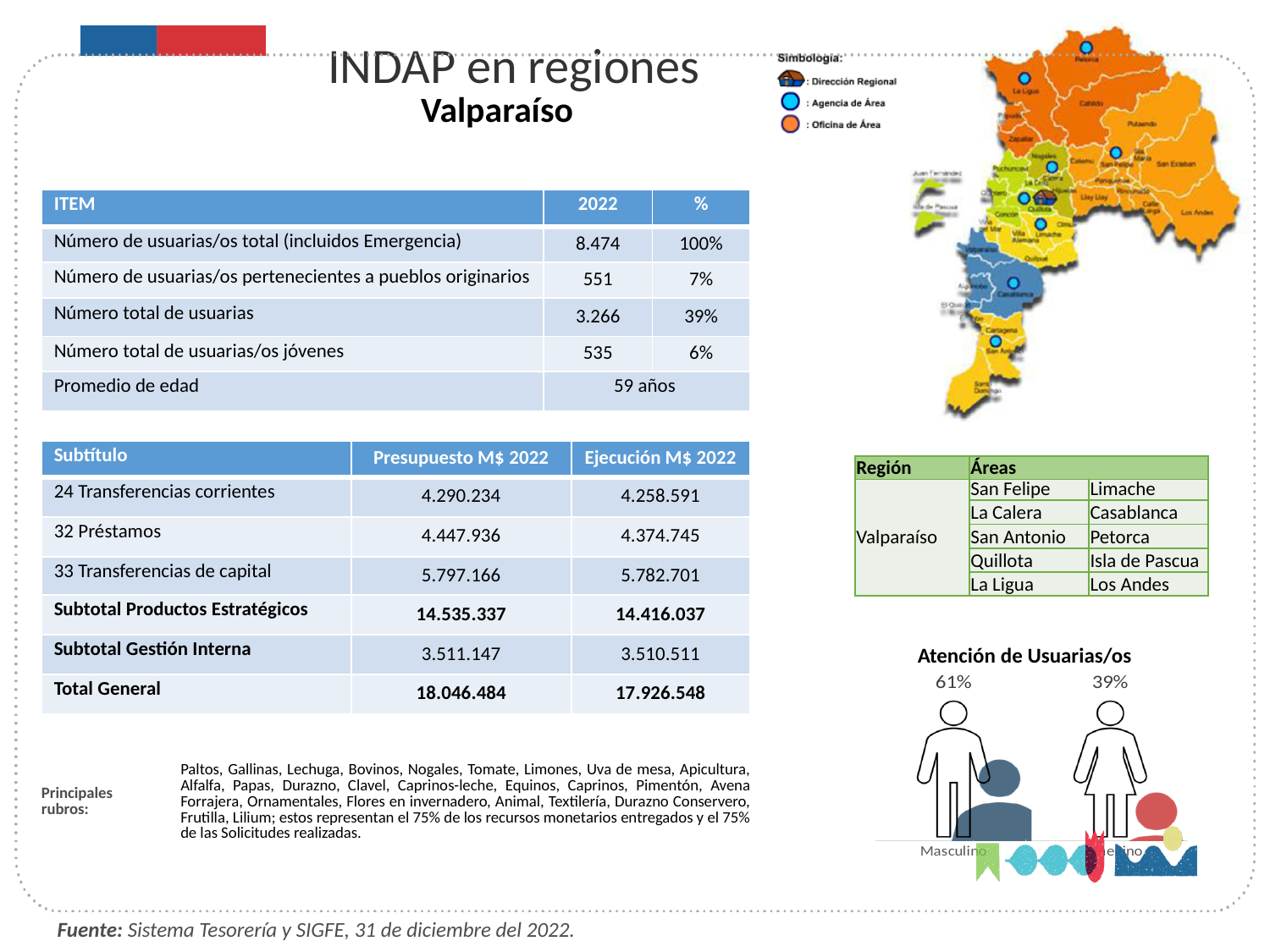
What kind of chart is 'Atención de Usuarias/os'? Bar chart In the chart 'Atención de Usuarias/os', which category has the highest value? Masculino How many categories are shown in the chart 'Atención de Usuarias/os'? 2 In the chart 'Atención de Usuarias/os', which category has the lowest value? Femenino In the chart 'Atención de Usuarias/os', which is larger, the value for Masculino or the value for Femenino? Masculino In the chart 'Atención de Usuarias/os', what is the difference between the Masculino and Femenino values? 22 percentage points In the chart 'Atención de Usuarias/os', what is the value shown for Masculino? 61% In the chart 'Atención de Usuarias/os', what is the value shown for the second category (Femenino)? 39% In the chart 'Atención de Usuarias/os', what do the two percentage values add up to? 100% What is the title of the chart at the bottom right of the slide? Atención de Usuarias/os